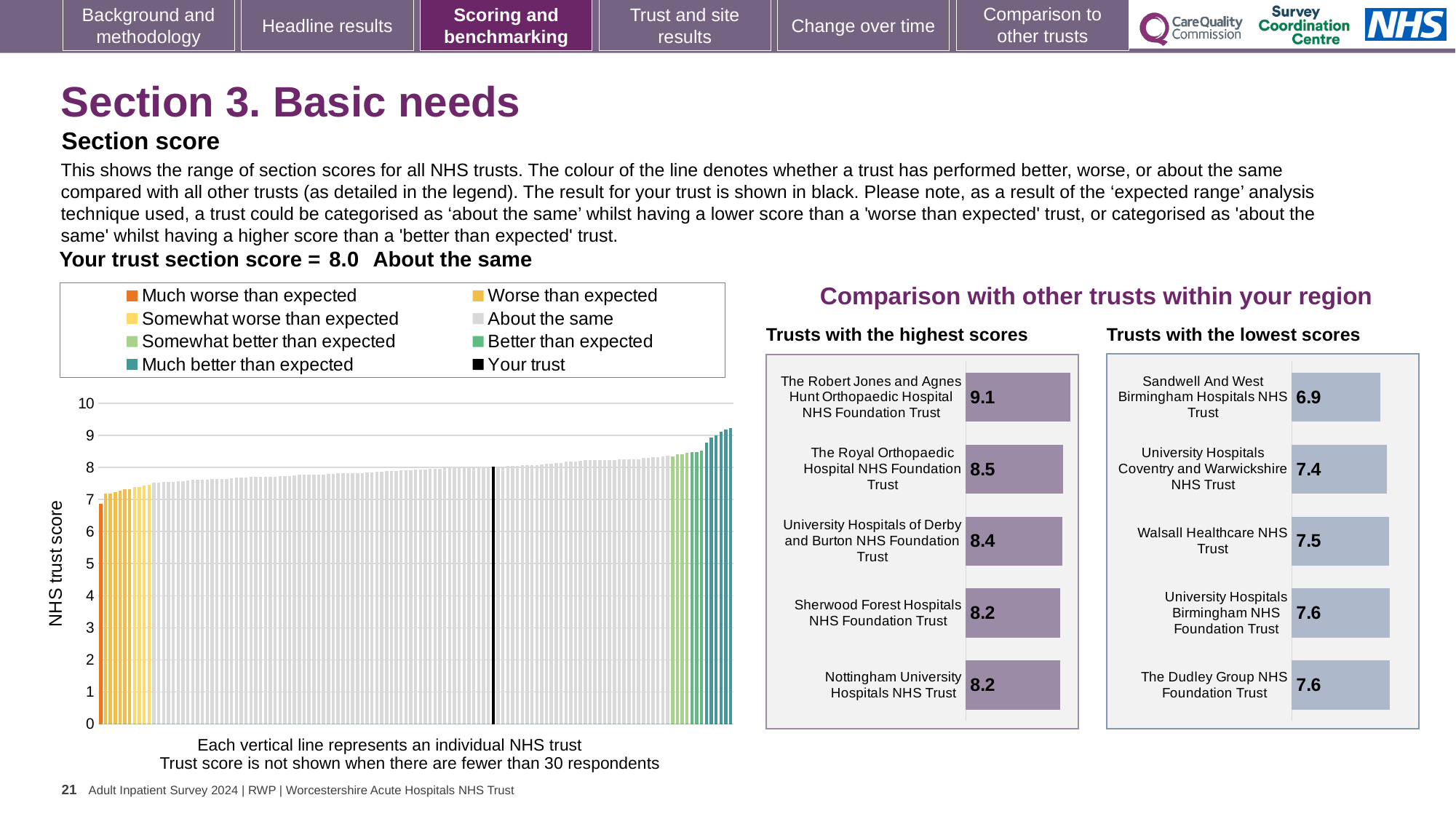
In the NHS trust score chart on the left, is the value for your trust (the black bar) greater or less than 9? less In the 'Trusts with the highest scores' chart, which has the higher score: University Hospitals of Derby and Burton NHS Foundation Trust or Sherwood Forest Hospitals NHS Foundation Trust? University Hospitals of Derby and Burton NHS Foundation Trust What kind of chart is the NHS trust score chart on the left of the slide? bar chart In the 'Trusts with the lowest scores' chart, how much higher is The Dudley Group NHS Foundation Trust's score than Sandwell And West Birmingham Hospitals NHS Trust's score? 0.7 In the 'Trusts with the lowest scores' chart, what is the score for Walsall Healthcare NHS Trust? 7.5 In the 'Trusts with the lowest scores' chart, which trust has the lowest score? Sandwell And West Birmingham Hospitals NHS Trust In the 'Trusts with the highest scores' chart, which trust has the highest score? The Robert Jones and Agnes Hunt Orthopaedic Hospital NHS Foundation Trust How many entries does the legend of the NHS trust score chart on the left list? 8 In the 'Trusts with the highest scores' chart, what is the score for The Robert Jones and Agnes Hunt Orthopaedic Hospital NHS Foundation Trust? 9.1 In the 'Trusts with the highest scores' chart, what is the difference between the scores of The Robert Jones and Agnes Hunt Orthopaedic Hospital NHS Foundation Trust and The Royal Orthopaedic Hospital NHS Foundation Trust? 0.6 In the NHS trust score chart on the left, do the values rise or fall from left to right along the x axis? rise How many trusts are shown in the 'Trusts with the lowest scores' chart? 5